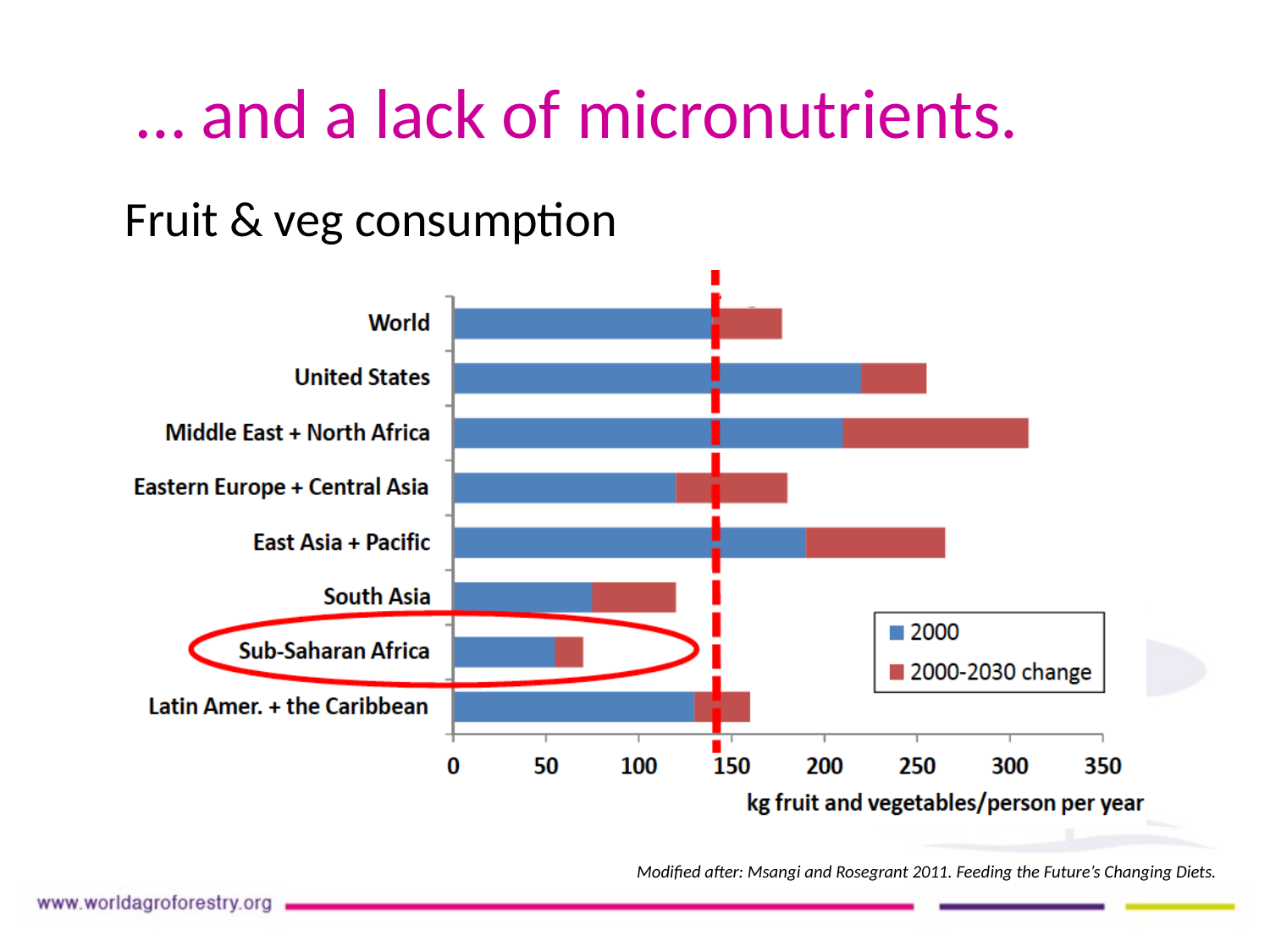
Which region has the lowest 2000 value? Sub-Saharan Africa How many regions (categories) are plotted in the chart? 8 Which region has the longest total bar (2000 plus 2000-2030 change)? Middle East + North Africa Is the 2000 value for United States greater or less than 200? greater What kind of chart is shown on the slide? bar chart Which region has the shortest total bar? Sub-Saharan Africa What is the label on the x axis of the chart? kg fruit and vegetables/person per year How many series does the legend list? 2 Is the total bar for Middle East + North Africa greater or less than 300? greater Which has the longer total bar, United States or World? United States Is the 2000 value for Sub-Saharan Africa greater or less than 100? less Which has the larger 2000 value, South Asia or Sub-Saharan Africa? South Asia